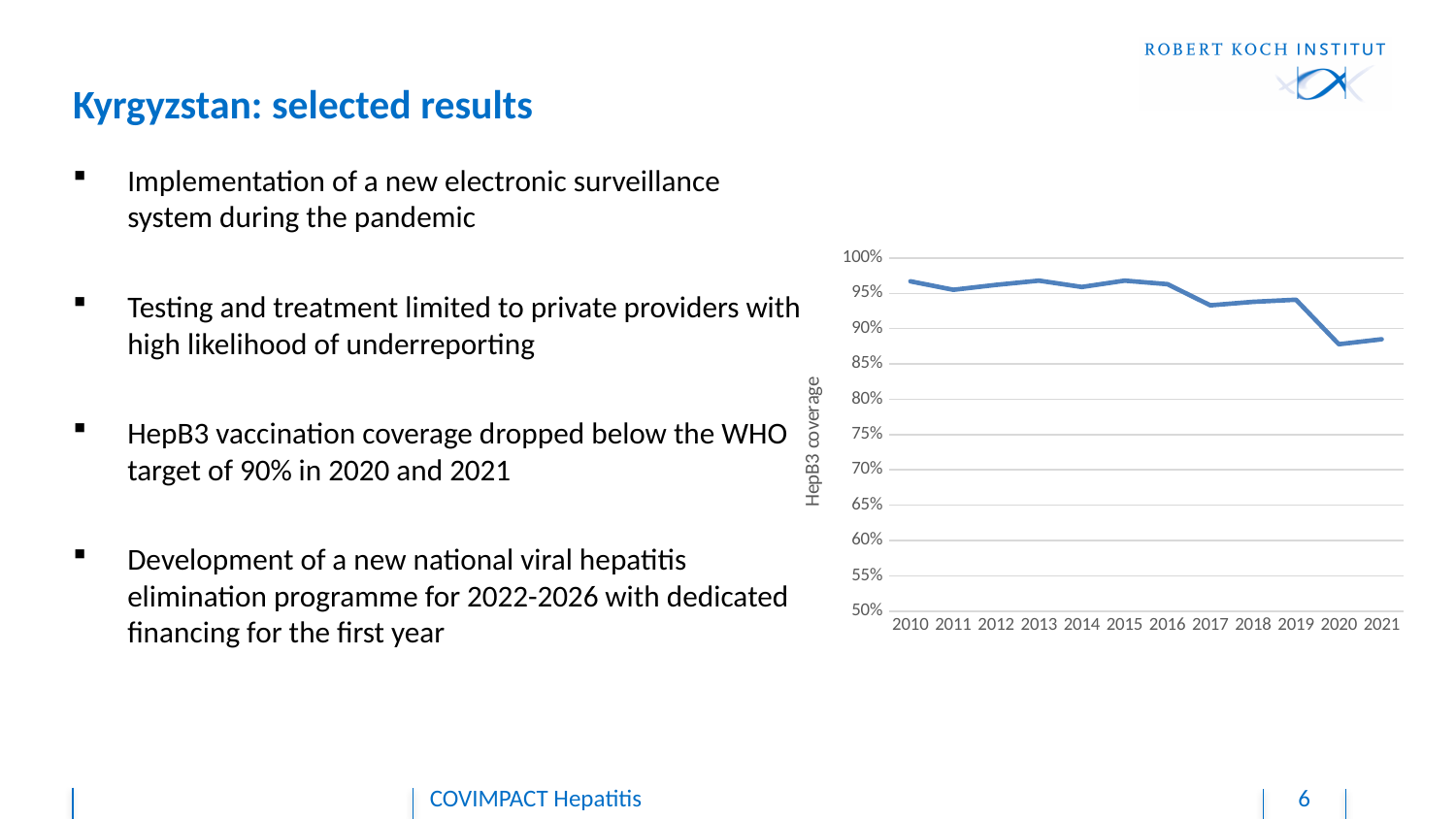
Is the HepB3 coverage value for 2010 greater or less than 95%? greater How many years are plotted along the x axis of the chart? 12 Is the HepB3 coverage value for 2021 greater or less than 90%? less What is the first year shown on the x axis of the chart? 2010 Is the HepB3 coverage value for 2020 greater or less than 90%? less Which year has the higher HepB3 coverage, 2010 or 2020? 2010 What kind of chart is shown on the slide? line chart Does HepB3 coverage generally rise or fall from 2010 to 2021? fall Which year has the higher HepB3 coverage, 2017 or 2021? 2017 What is the label of the vertical axis of the chart? HepB3 coverage